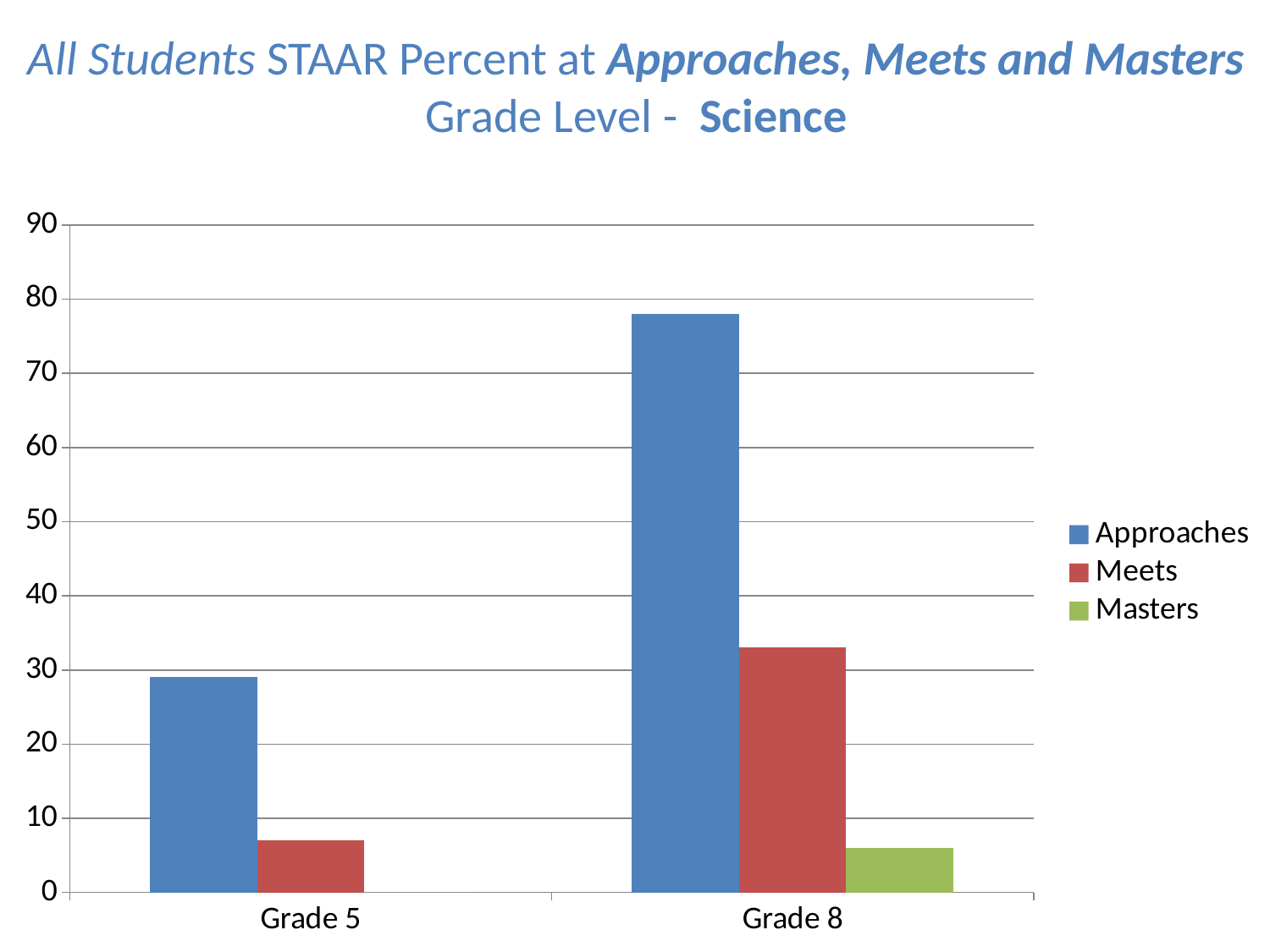
Does the Approaches value rise or fall from Grade 5 to Grade 8? rise Is the Meets value for Grade 8 greater or less than 30? greater How many grade-level categories are shown on the x axis? 2 Which colour represents the Masters series in the legend? green How many series does the legend list? 3 Is the Approaches value for Grade 8 greater or less than 70? greater Which grade level has the highest Approaches value? Grade 8 What kind of chart is shown on the slide? bar chart Is the Meets value for Grade 5 greater or less than 10? less Which grade level has the lowest Meets value? Grade 5 Which is larger for Grade 8: the Meets value or the Masters value? Meets